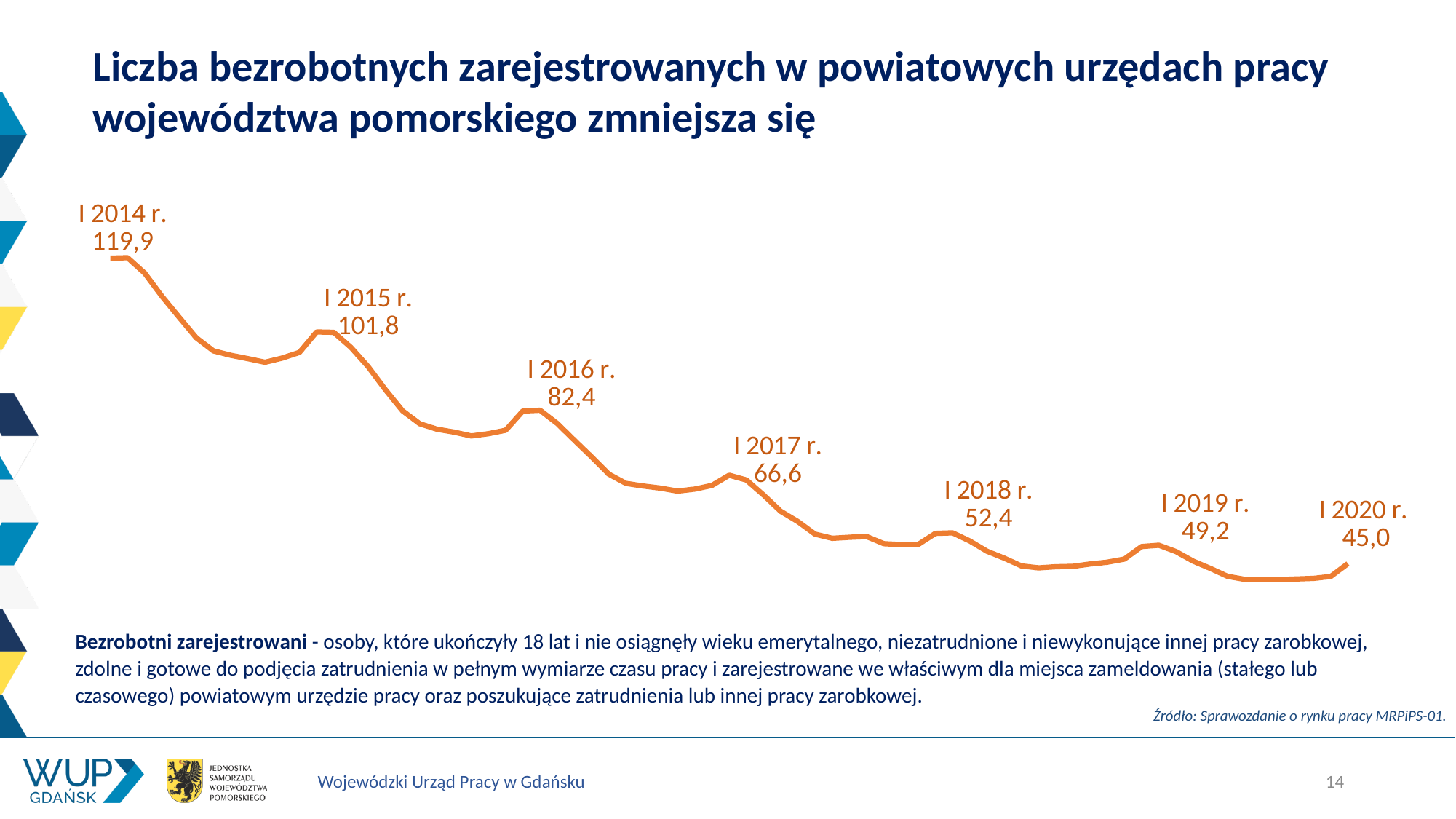
Which is larger, the value for I 2016 r. or the value for I 2017 r.? I 2016 r. What is the difference between the values for I 2014 r. and I 2015 r.? 18,1 What is the difference between the values for I 2018 r. and I 2019 r.? 3,2 Do the values rise or fall from I 2014 r. to I 2020 r.? fall What is the difference between the values for I 2014 r. and I 2020 r.? 74,9 Which labeled point has the highest value? I 2014 r. What value is shown for I 2020 r.? 45,0 How many labeled data points are shown on the chart? 7 What kind of chart is shown on the slide? line chart What value is shown for I 2017 r.? 66,6 Which labeled point has the lowest value? I 2020 r. What value is shown for I 2014 r.? 119,9